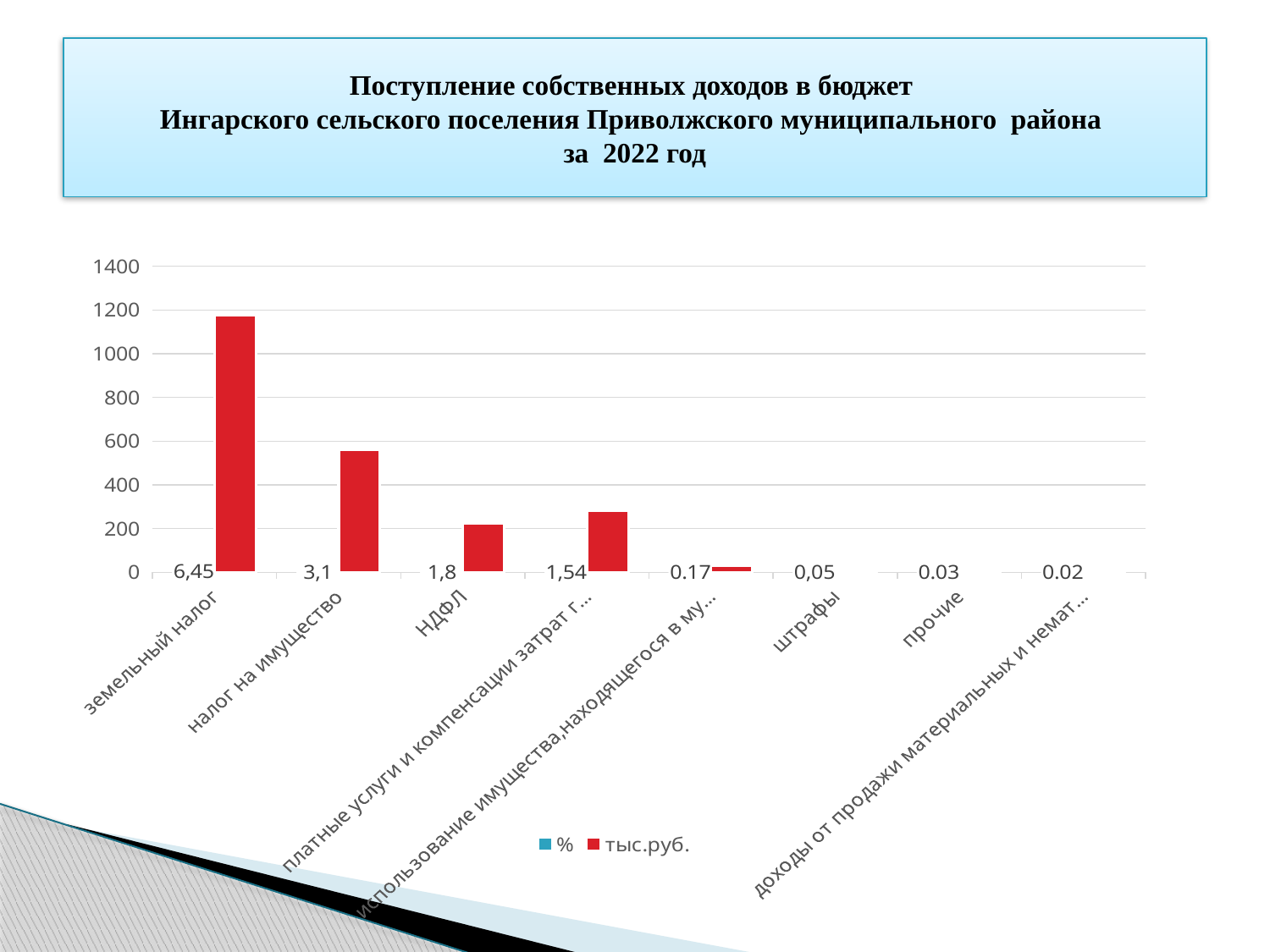
How many series does the legend list? 2 What is the difference between the % values labelled for земельный налог (6,45) and налог на имущество (3,1)? 3,35 Which has the larger тыс.руб. bar: налог на имущество or НДФЛ? налог на имущество Is the тыс.руб. value for НДФЛ greater or less than 400? less Is the тыс.руб. value for земельный налог greater or less than 1000? greater Is the тыс.руб. value for налог на имущество greater or less than 400? greater What kind of chart is shown on the slide? bar chart Which category has the highest тыс.руб. bar? земельный налог How many categories are shown on the x axis? 8 Do the тыс.руб. bars generally rise or fall from left to right along the x axis? fall What is the % value labelled for земельный налог? 6,45 What is the % value labelled for штрафы? 0,05